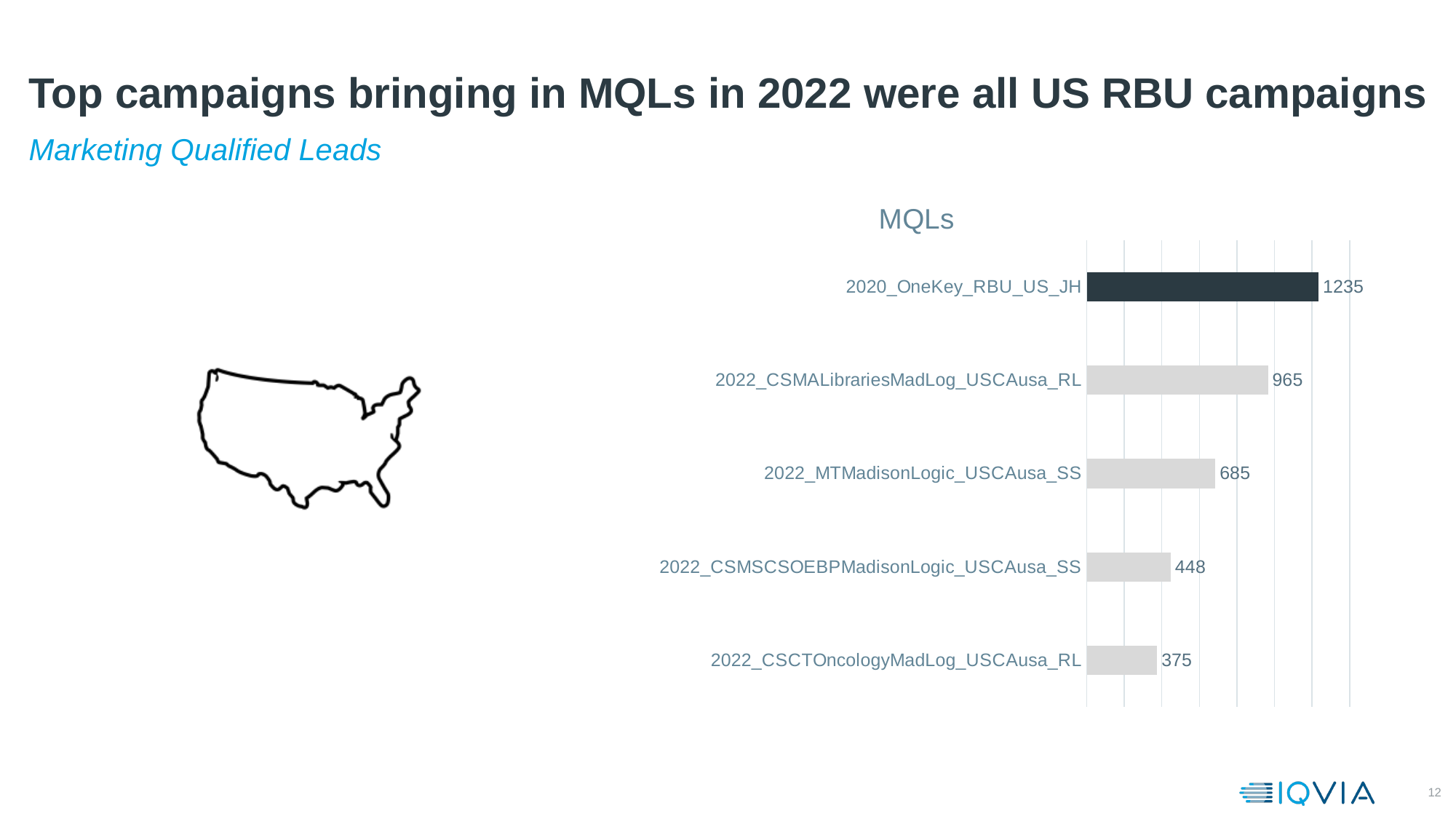
How many campaigns are shown in the chart? 5 What is the difference in MQLs between 2020_OneKey_RBU_US_JH and 2022_CSMALibrariesMadLog_USCAusa_RL? 270 What is the title of the chart? MQLs Which has more MQLs, 2022_MTMadisonLogic_USCAusa_SS or 2022_CSMSCSOEBPMadisonLogic_USCAusa_SS? 2022_MTMadisonLogic_USCAusa_SS What is the MQLs value for 2022_CSCTOncologyMadLog_USCAusa_RL? 375 What is the MQLs value for 2022_MTMadisonLogic_USCAusa_SS? 685 Which campaign has the highest number of MQLs? 2020_OneKey_RBU_US_JH What is the MQLs value for 2020_OneKey_RBU_US_JH? 1235 What is the difference in MQLs between 2022_CSMSCSOEBPMadisonLogic_USCAusa_SS and 2022_CSCTOncologyMadLog_USCAusa_RL? 73 What kind of chart is shown on the slide? Bar chart Which campaign has the lowest number of MQLs? 2022_CSCTOncologyMadLog_USCAusa_RL What is the MQLs value for 2022_CSMALibrariesMadLog_USCAusa_RL? 965